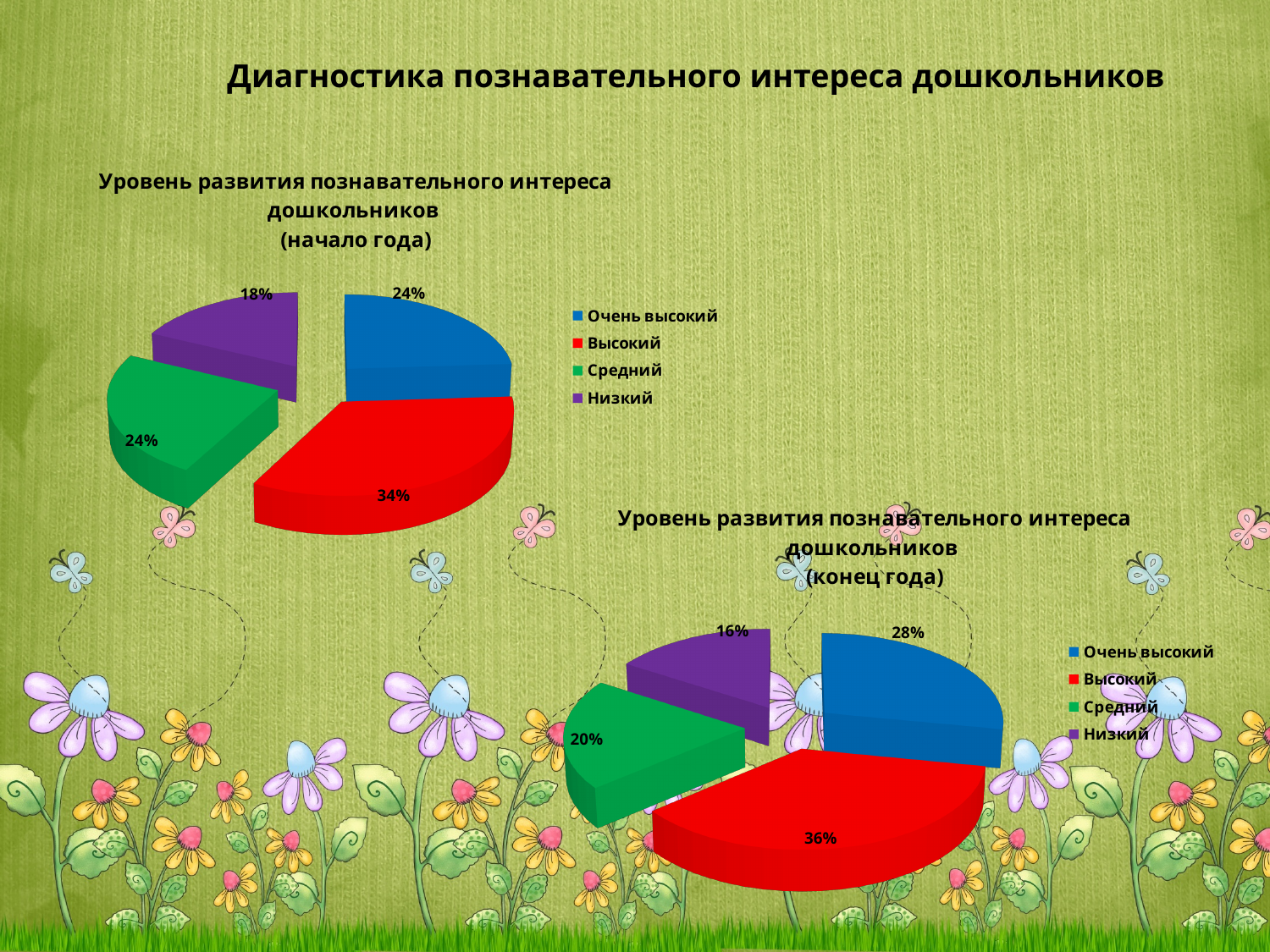
What type of chart is the chart titled "Уровень развития познавательного интереса дошкольников (начало года)"? Pie chart In the chart titled "Уровень развития познавательного интереса дошкольников (конец года)", what is the difference between the Высокий and Низкий shares? 20% In the chart titled "Уровень развития познавательного интереса дошкольников (конец года)", what is the value for Средний? 20% In the chart titled "Уровень развития познавательного интереса дошкольников (конец года)", what colour is the Средний slice? Green In the chart titled "Уровень развития познавательного интереса дошкольников (начало года)", which category has the largest share? Высокий In the chart titled "Уровень развития познавательного интереса дошкольников (начало года)", what is the value for Низкий? 18% How many entries does the legend of the chart titled "Уровень развития познавательного интереса дошкольников (начало года)" list? 4 In the chart titled "Уровень развития познавательного интереса дошкольников (конец года)", what is the value for Очень высокий? 28% In the chart titled "Уровень развития познавательного интереса дошкольников (начало года)", which is larger: Очень высокий or Низкий? Очень высокий In the chart titled "Уровень развития познавательного интереса дошкольников (конец года)", which category has the smallest share? Низкий In the chart titled "Уровень развития познавательного интереса дошкольников (начало года)", what is the value for Высокий? 34% How many categories does the chart titled "Уровень развития познавательного интереса дошкольников (конец года)" show? 4